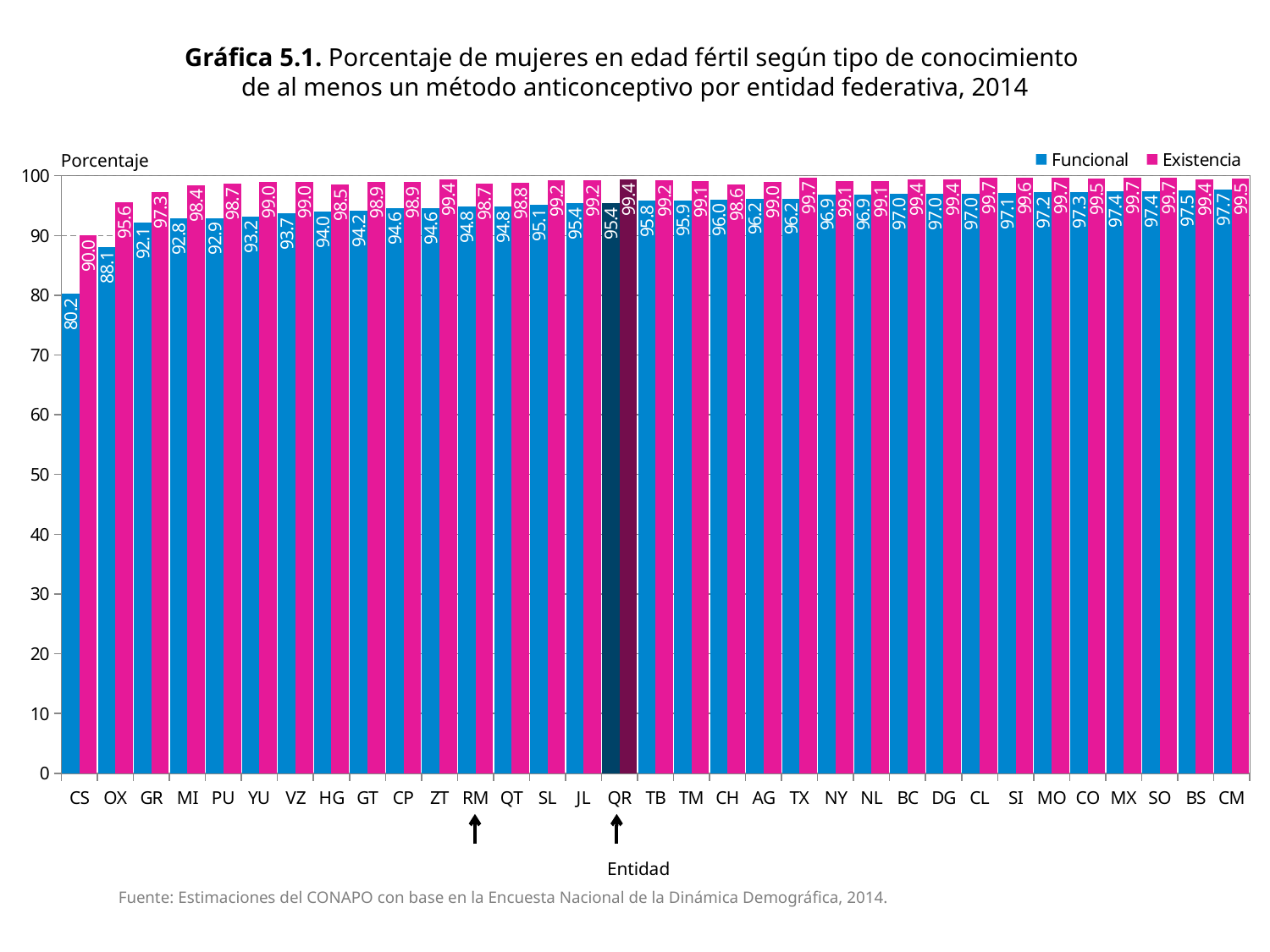
Which entity has the highest Funcional value? CM Which is larger for GR: the Funcional value or the Existencia value? Existencia How many series does the legend list? 2 What is the difference between the Existencia and Funcional values for CS? 9.8 Which entity has the lowest Existencia value? CS What is the Funcional value for CS? 80.2 Which entity has the lowest Funcional value? CS What is the Funcional value for QR? 95.4 What kind of chart is shown on the slide? Bar chart What is the Existencia value for RM? 98.7 What is the Existencia value for OX? 95.6 How many entities are shown on the x axis? 33